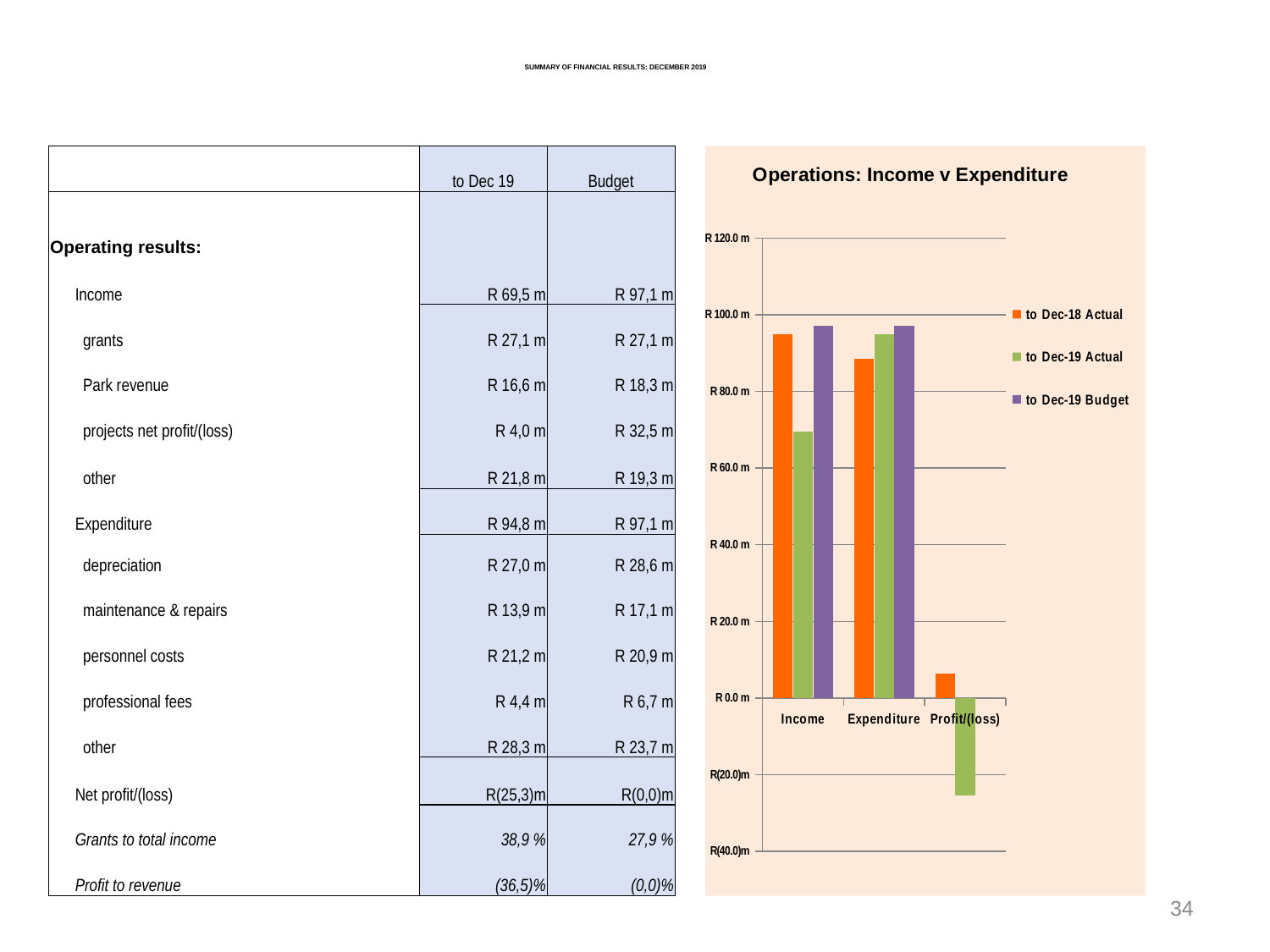
What is the title of the chart? Operations: Income v Expenditure What kind of chart is shown on the slide? bar chart For Income, which is larger: the to Dec-19 Actual value or the to Dec-19 Budget value? to Dec-19 Budget Is the to Dec-19 Actual value for Income greater or less than R 80.0 m? less Is the to Dec-18 Actual value for Profit/(loss) greater or less than R 20.0 m? less Is the to Dec-18 Actual value for Income greater or less than R 80.0 m? greater Which series is shown in green in the chart? to Dec-19 Actual How many categories are shown on the x axis of the chart? 3 Which category has the highest to Dec-19 Actual value? Expenditure Which category has the lowest to Dec-19 Actual value? Profit/(loss) How many series does the chart's legend list? 3